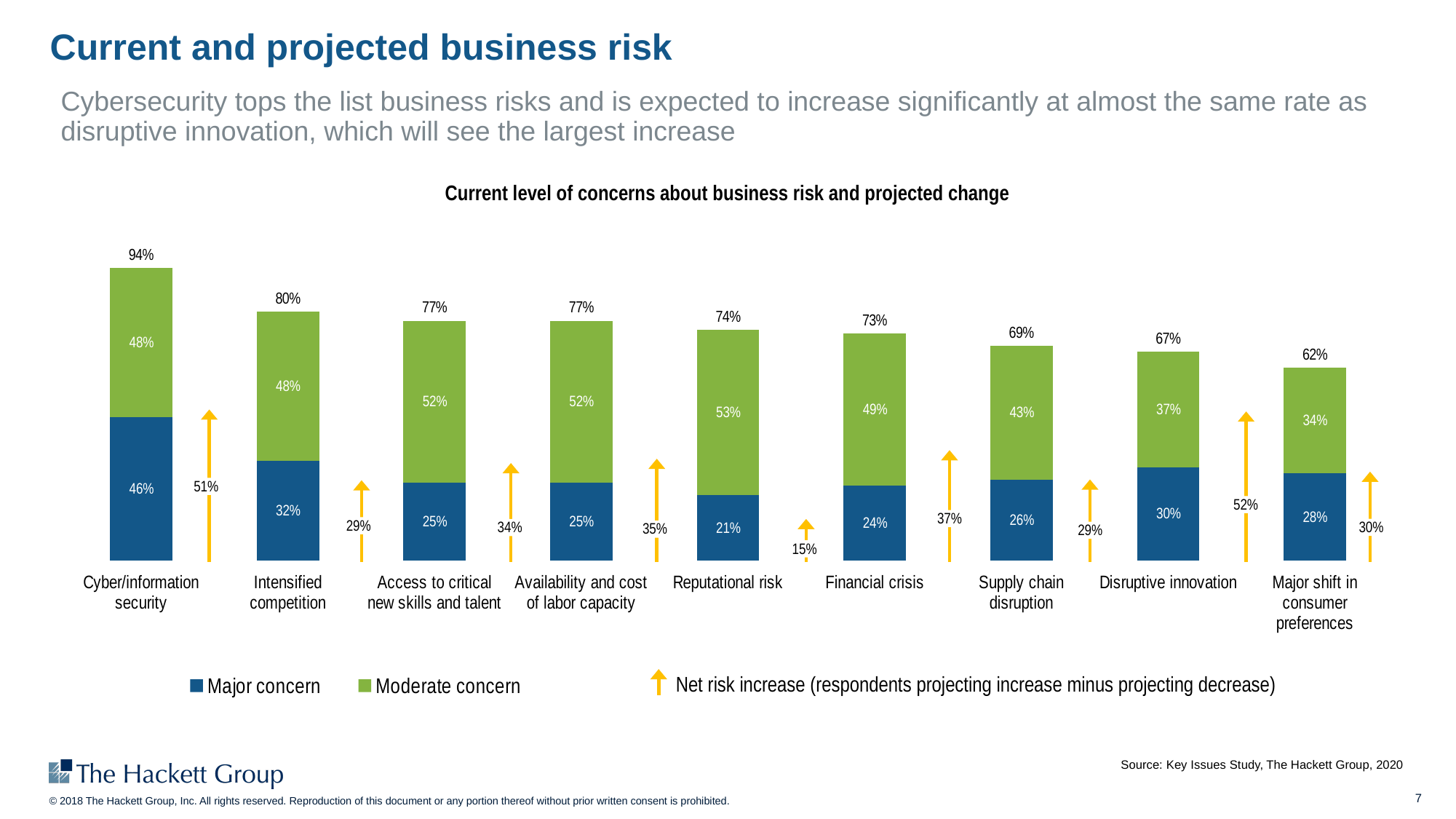
What type of chart is shown on the slide? Stacked bar chart Which category has the lowest total level of concern? Major shift in consumer preferences Which category has the lowest net risk increase? Reputational risk What is the difference between the Major concern values for Intensified competition and Supply chain disruption? 6% Which is larger, the Moderate concern value for Supply chain disruption or for Disruptive innovation? Supply chain disruption What is the Moderate concern value for Reputational risk? 53% Which category has the highest total level of concern? Cyber/information security What is the net risk increase shown for Disruptive innovation? 52% What is the Major concern value for Cyber/information security? 46% How many stacked bar series does the legend list? 2 How many categories are shown on the x axis? 9 What is the total of the stacked bar for Financial crisis? 73%